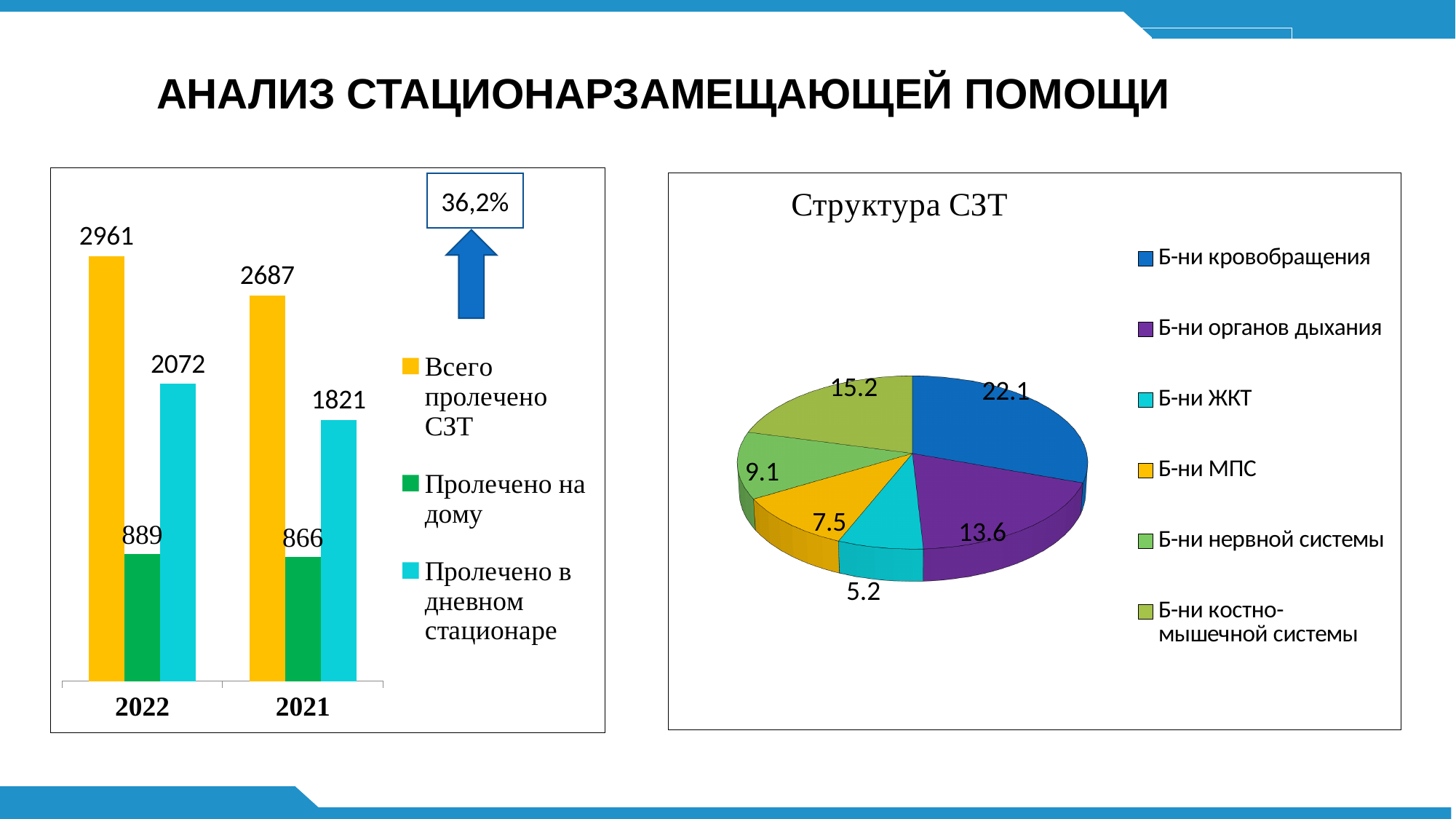
In the 'Структура СЗТ' chart, what is the value for 'Б-ни ЖКТ'? 5.2 In the bar chart on the left, how many series does the legend list? 3 In the 'Структура СЗТ' chart, what is the value for 'Б-ни кровобращения'? 22.1 How many categories does the 'Структура СЗТ' pie chart show? 6 In the bar chart on the left, what is the difference between 'Всего пролечено СЗТ' in 2022 and in 2021? 274 In the bar chart on the left, what is the value of 'Всего пролечено СЗТ' for 2022? 2961 In the 'Структура СЗТ' chart, which category has the smallest slice? Б-ни ЖКТ In the bar chart on the left, what is the value of 'Пролечено в дневном стационаре' for 2022? 2072 What type of chart is the chart on the left of the slide? Bar chart In the 'Структура СЗТ' chart, which category has the largest slice? Б-ни кровобращения In the bar chart on the left, what is the value of 'Пролечено на дому' for 2021? 866 In the bar chart on the left, which year has the higher value for 'Пролечено в дневном стационаре', 2022 or 2021? 2022